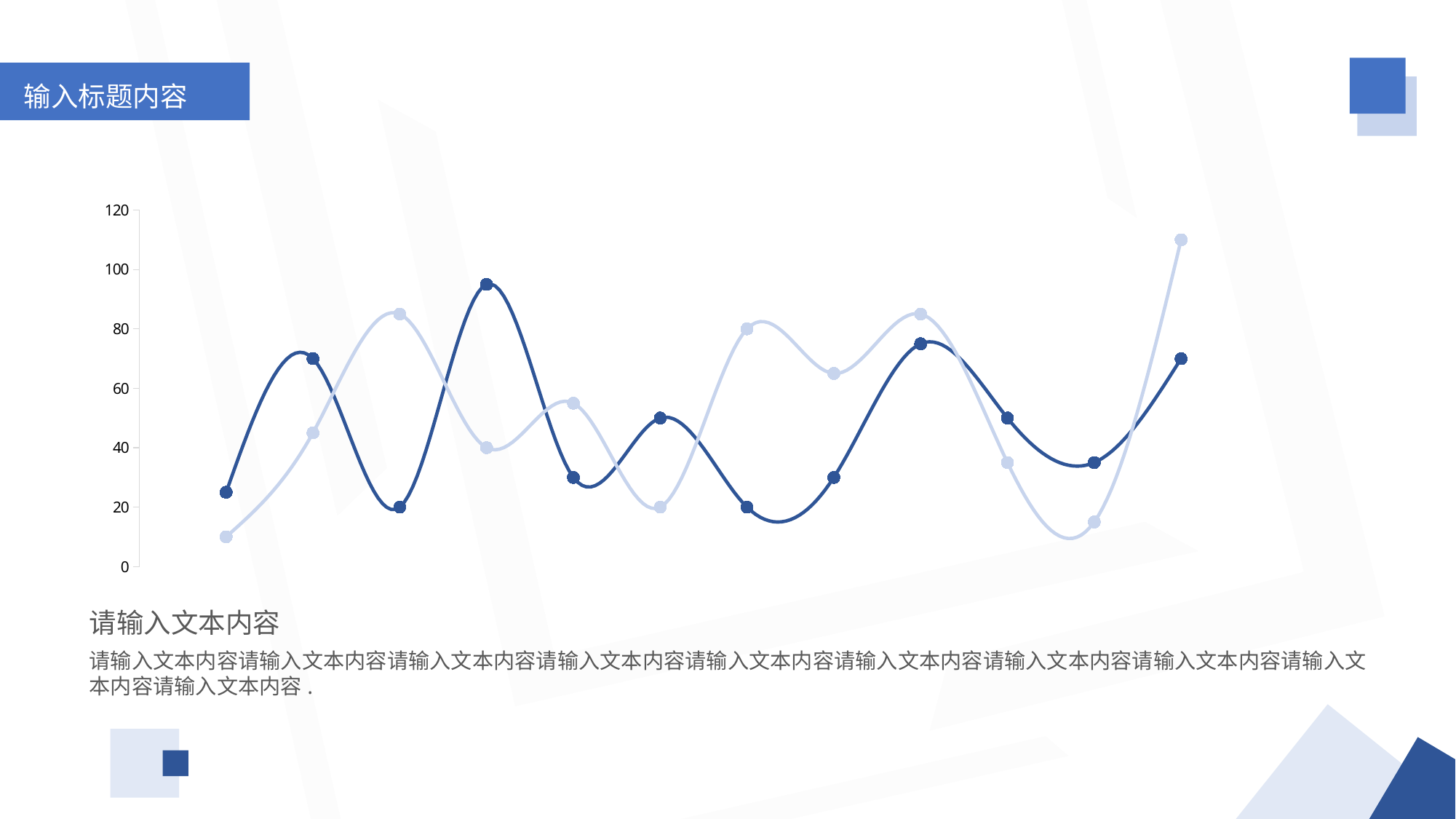
How many data points does the light blue line have? 12 Is the highest point of the dark blue line greater or less than 100? less Is the lowest point of the light blue line greater or less than 20? less Which line has the lower first point, the dark blue line or the light blue line? light blue line Is the first point of the dark blue line greater or less than 40? less What kind of chart is shown on the slide? line chart Which line reaches the higher peak, the dark blue line or the light blue line? light blue line What is the maximum value shown on the vertical axis? 120 How many lines are plotted on the chart? 2 How many data points does the dark blue line have? 12